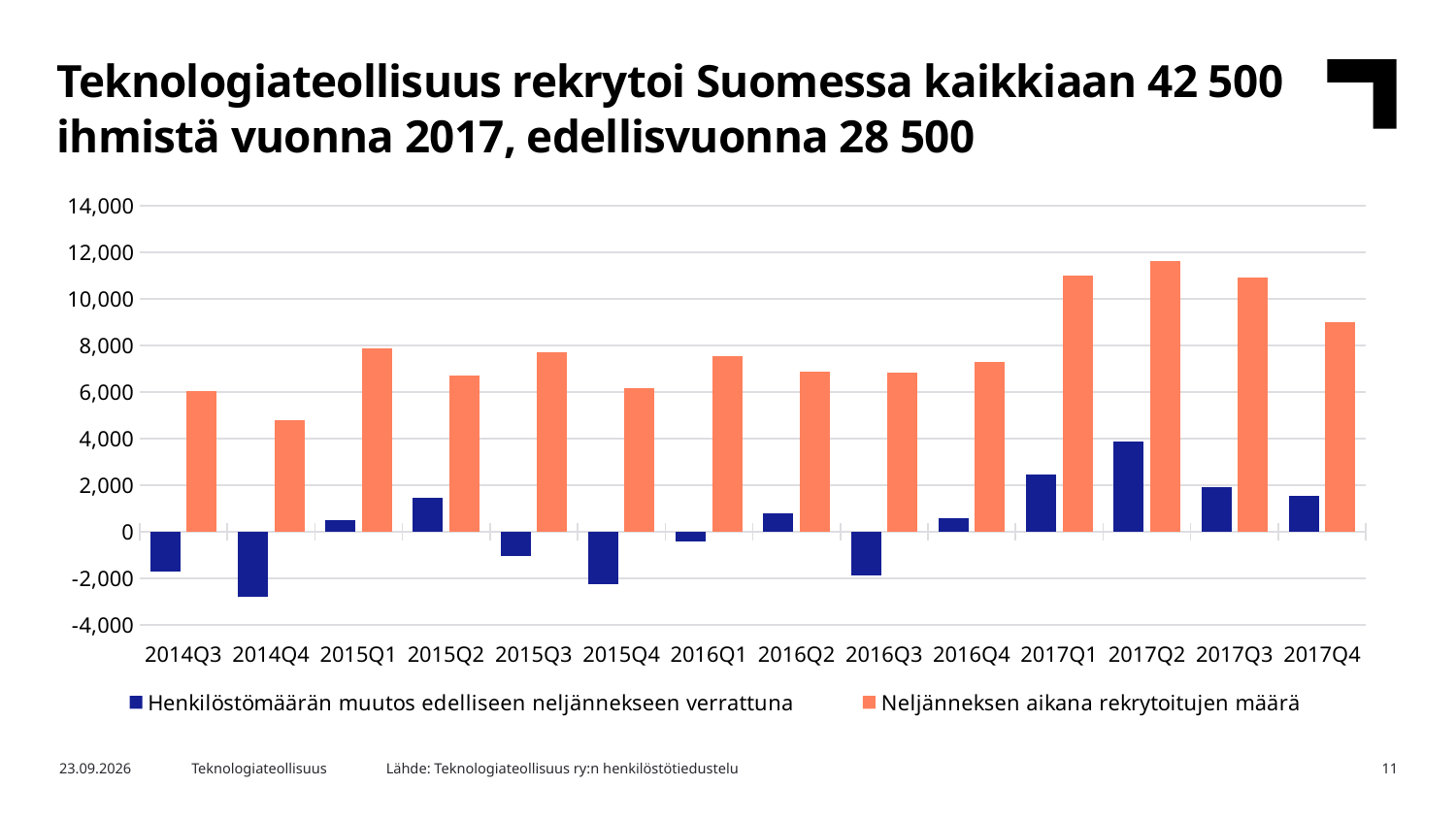
In which quarter is the value for 'Henkilöstömäärän muutos edelliseen neljännekseen verrattuna' lowest? 2014Q4 Which series is shown in orange? Neljänneksen aikana rekrytoitujen määrä Which is larger: the value for 'Neljänneksen aikana rekrytoitujen määrä' in 2015Q1 or in 2014Q4? 2015Q1 How many quarters are shown on the x axis? 14 In which quarter is the value for 'Neljänneksen aikana rekrytoitujen määrä' lowest? 2014Q4 Is the value for 'Neljänneksen aikana rekrytoitujen määrä' in 2017Q1 greater or less than 10,000? greater In which quarter is the value for 'Neljänneksen aikana rekrytoitujen määrä' highest? 2017Q2 Is the value for 'Neljänneksen aikana rekrytoitujen määrä' in 2017Q4 greater or less than 10,000? less What kind of chart is shown on the slide? bar chart How many series does the legend list? 2 In which quarter is the value for 'Henkilöstömäärän muutos edelliseen neljännekseen verrattuna' highest? 2017Q2 Is the value for 'Henkilöstömäärän muutos edelliseen neljännekseen verrattuna' in 2014Q4 greater or less than -2,000? less